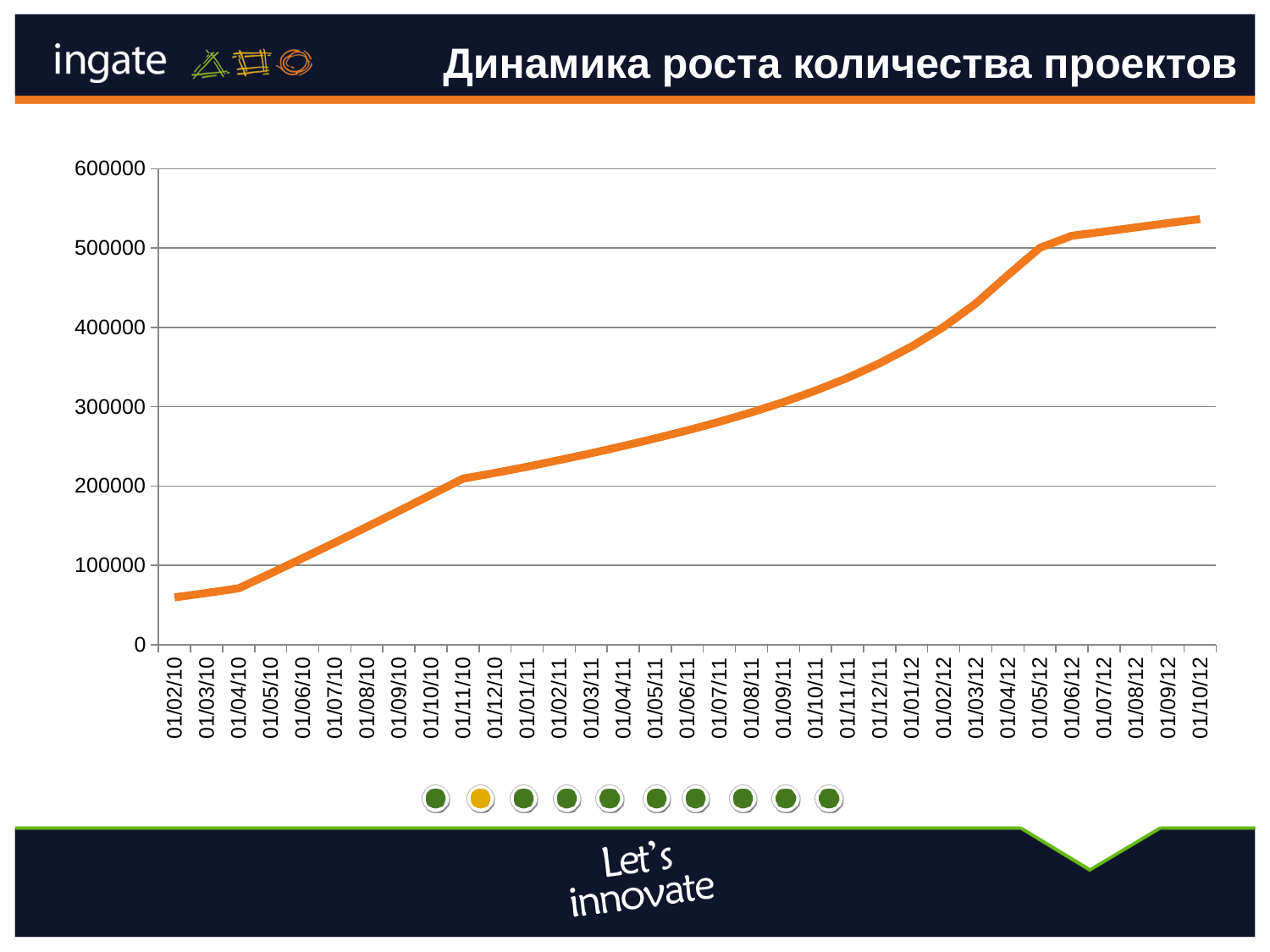
Do the values rise or fall along the x axis from 01/02/10 to 01/10/12? rise What kind of chart is shown on the slide? line chart Which date has the highest value on the chart? 01/10/12 Is the value for 01/07/10 greater or less than 100000? greater What is the title of the chart on the slide? Динамика роста количества проектов What colour is the line on the chart? orange Is the value for 01/02/10 greater or less than 100000? less Which is larger, the value for 01/10/12 or the value for 01/02/10? 01/10/12 Is the value for 01/05/11 greater or less than 300000? less How many dates are shown on the x axis of the chart? 33 Which date has the lowest value on the chart? 01/02/10